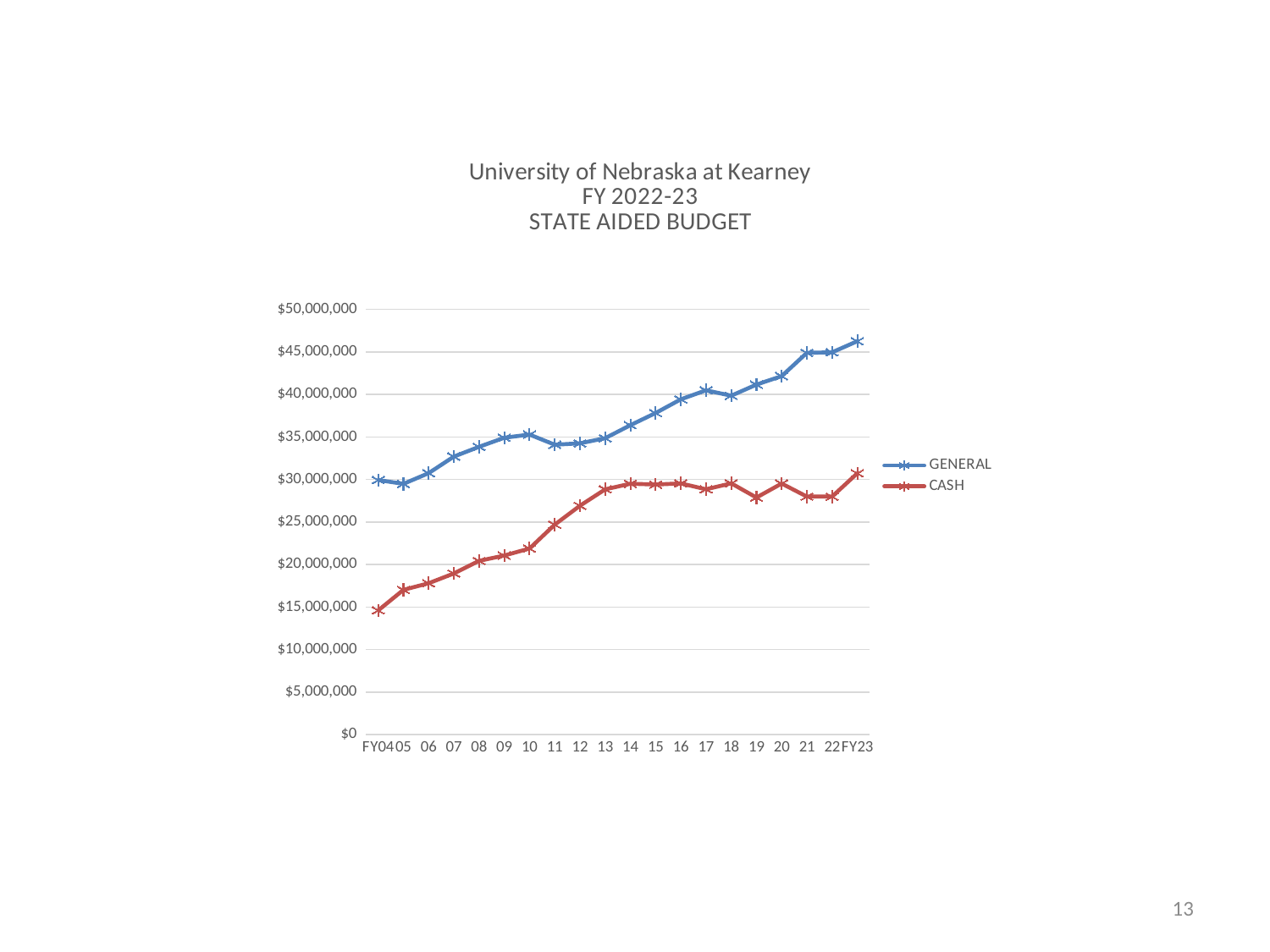
Is the CASH value for FY14 greater or less than $25,000,000? greater Is the GENERAL value for FY04 greater or less than $35,000,000? less What kind of chart is shown on the slide? line chart Is the GENERAL value for FY23 greater or less than $45,000,000? greater In which fiscal year is the GENERAL series at its highest? FY23 Does the GENERAL series generally rise or fall from FY04 to FY23? rise In which fiscal year is the CASH series at its lowest? FY04 How many fiscal years are plotted along the x axis? 20 What colour is the CASH line in the chart? red Which series is higher at FY23, GENERAL or CASH? GENERAL How many series does the legend list? 2